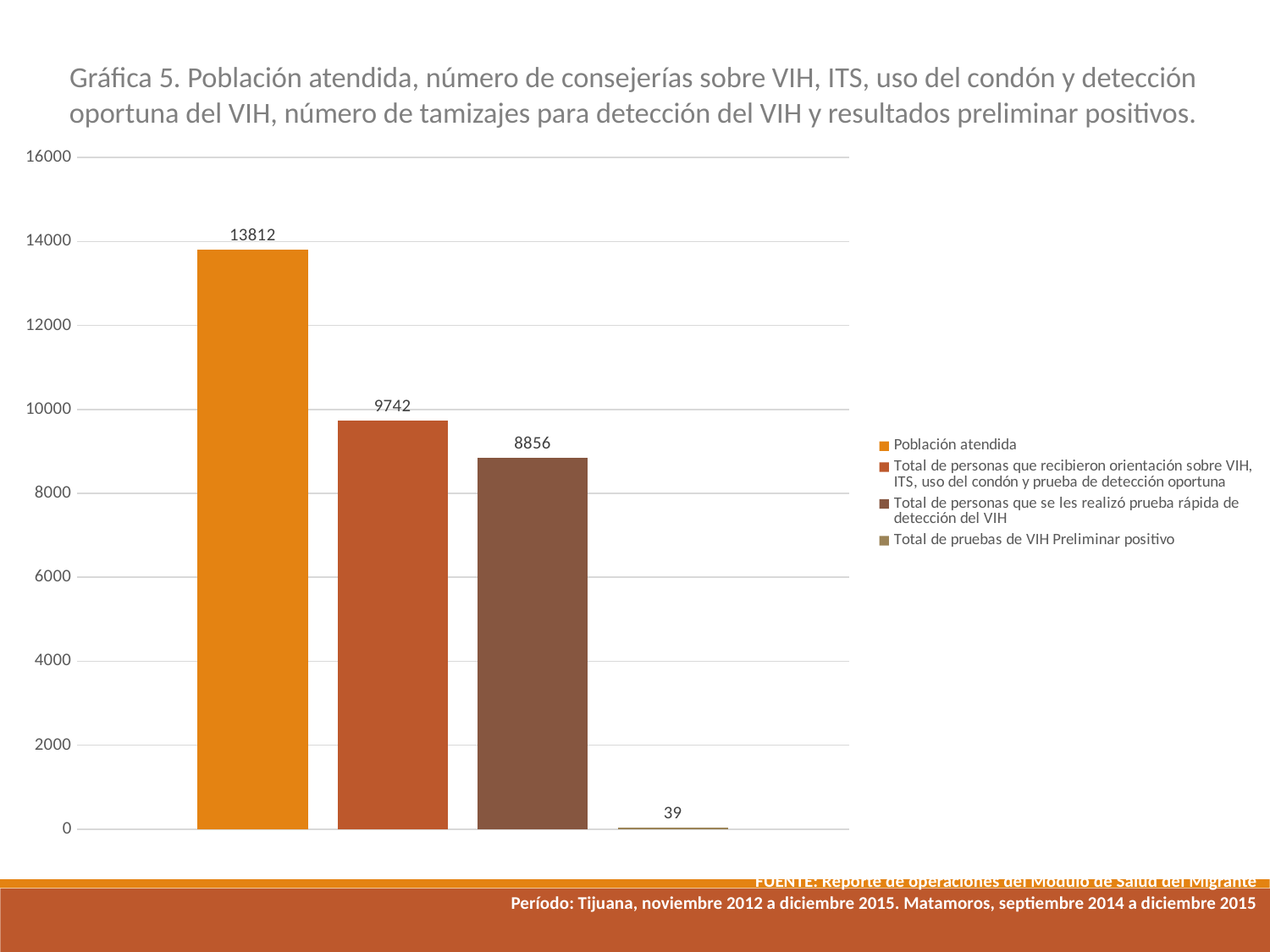
What is the value for Total de pruebas de VIH Preliminar positivo? 39 What kind of chart is shown on the slide? Bar chart Is the value for Población atendida greater or less than 12000? greater Which series has the highest value? Población atendida Which series has the lowest value? Total de pruebas de VIH Preliminar positivo What is the difference between Total de personas que recibieron orientación and Total de personas que se les realizó prueba rápida de detección del VIH? 886 How many series does the legend list? 4 Which is larger: Total de personas que recibieron orientación or Total de personas que se les realizó prueba rápida de detección del VIH? Total de personas que recibieron orientación What is the value for Total de personas que recibieron orientación sobre VIH, ITS, uso del condón y prueba de detección oportuna? 9742 What is the difference between Población atendida and Total de personas que recibieron orientación sobre VIH, ITS, uso del condón y prueba de detección oportuna? 4070 What is the value for Población atendida? 13812 What is the value for Total de personas que se les realizó prueba rápida de detección del VIH? 8856